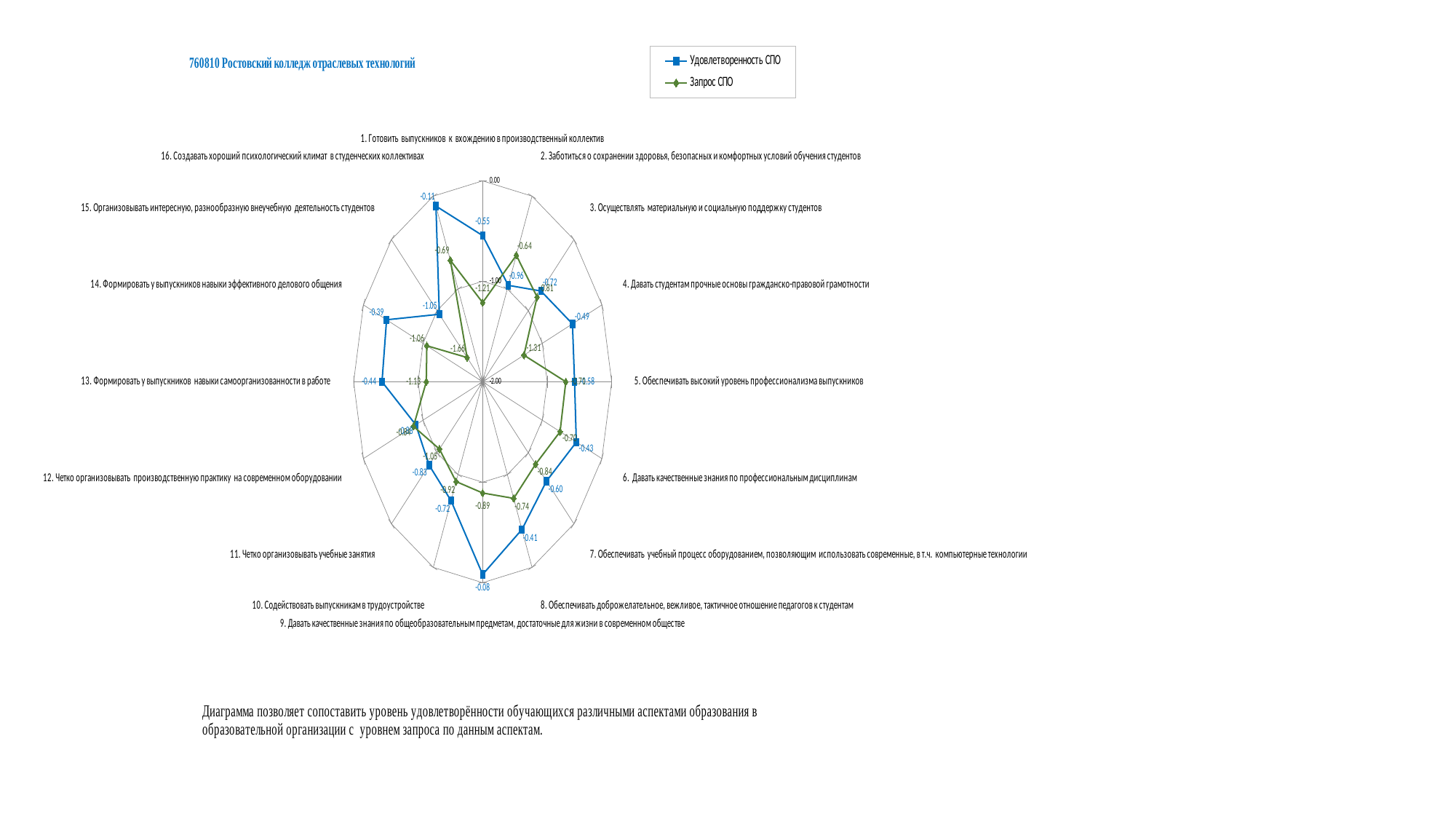
For category 13 (Формировать у выпускников навыки самоорганизованности в работе), which series has the higher value? Удовлетворенность СПО What is the value of Удовлетворенность СПО for category 9 (Давать качественные знания по общеобразовательным предметам)? -0.08 Which category has the lowest Запрос СПО value? 15. Организовывать интересную, разнообразную внеучебную деятельность студентов What is the value of Запрос СПО for category 15 (Организовывать интересную, разнообразную внеучебную деятельность студентов)? -1.66 How many categories (axes) does the radar chart have? 16 How many series does the legend list? 2 What is the title of the chart? 760810 Ростовский колледж отраслевых технологий What is the value of Запрос СПО for category 4 (Давать студентам прочные основы гражданско-правовой грамотности)? -1.31 What is the value of Удовлетворенность СПО for category 16 (Создавать хороший психологический климат в студенческих коллективах)? -0.11 What kind of chart is shown on the slide? Radar chart What is the difference between Удовлетворенность СПО and Запрос СПО for category 15? 0.61 Which category has the highest Удовлетворенность СПО value? 9. Давать качественные знания по общеобразовательным предметам, достаточные для жизни в современном обществе